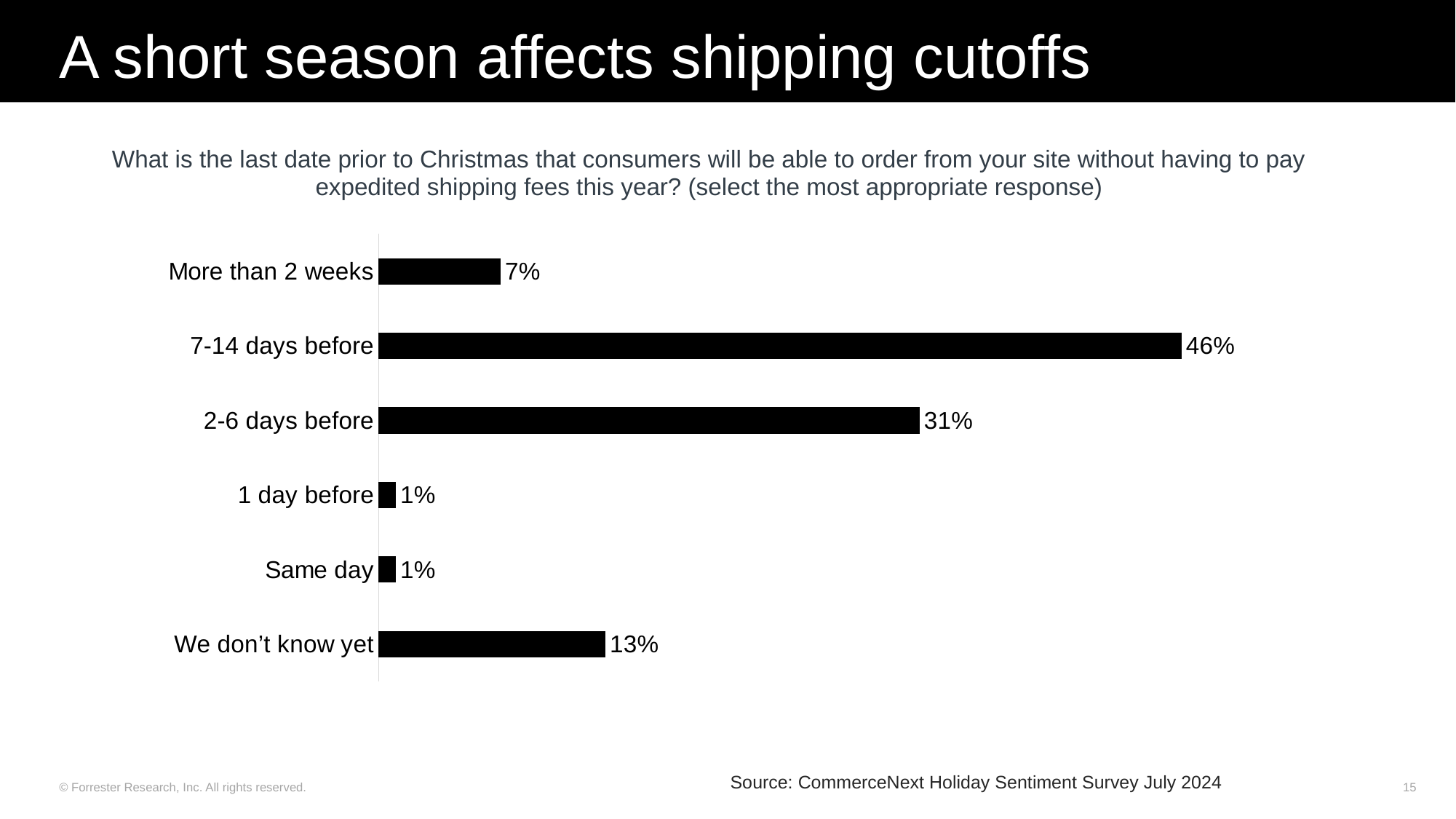
Which is larger, the value for "We don't know yet" or the value for "More than 2 weeks"? We don't know yet How many response categories are shown in the chart? 6 What is the value shown for "We don't know yet"? 13% What is the difference between the values for "2-6 days before" and "We don't know yet"? 18% Which response category has the highest value? 7-14 days before What is the value shown for "1 day before"? 1% What kind of chart is shown on the slide? Bar chart What is the difference between the values for "7-14 days before" and "2-6 days before"? 15% What percentage of respondents selected "7-14 days before"? 46% What colour are the bars in the chart? Black What percentage is shown for "More than 2 weeks"? 7% What is the source cited for the chart data? CommerceNext Holiday Sentiment Survey July 2024